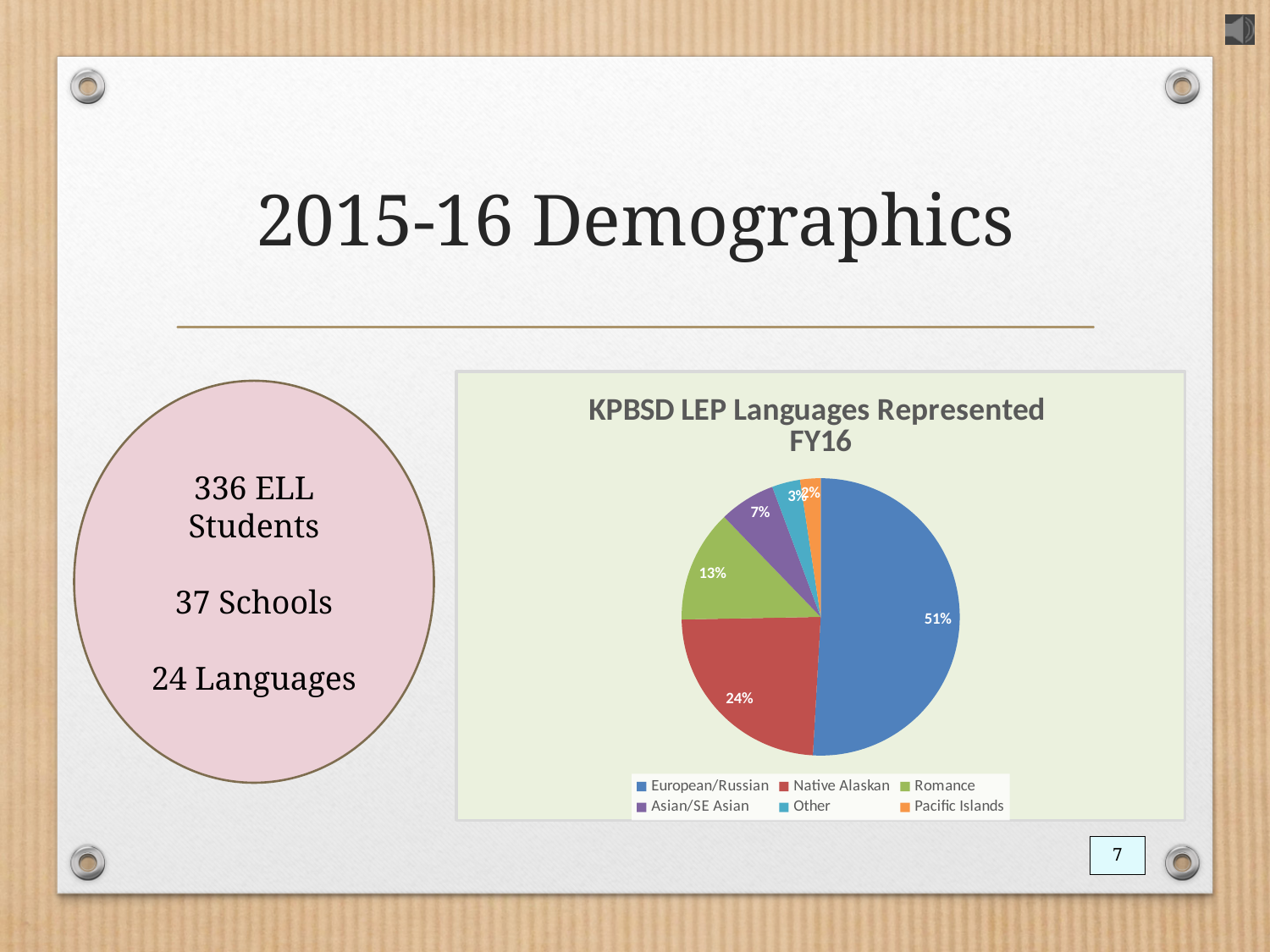
What share of the pie is European/Russian? 51% What kind of chart is shown on the slide? pie chart Which language group has the largest share of the pie? European/Russian Which has a larger share, Romance or Asian/SE Asian? Romance How many slices does the pie chart have? 6 What share of the pie is Romance? 13% How many entries does the chart legend list? 6 What is the difference in percentage points between the European/Russian share and the Native Alaskan share? 27 What is the title of the chart? KPBSD LEP Languages Represented FY16 What share of the pie is Native Alaskan? 24% Which language group has the smallest share of the pie? Pacific Islands